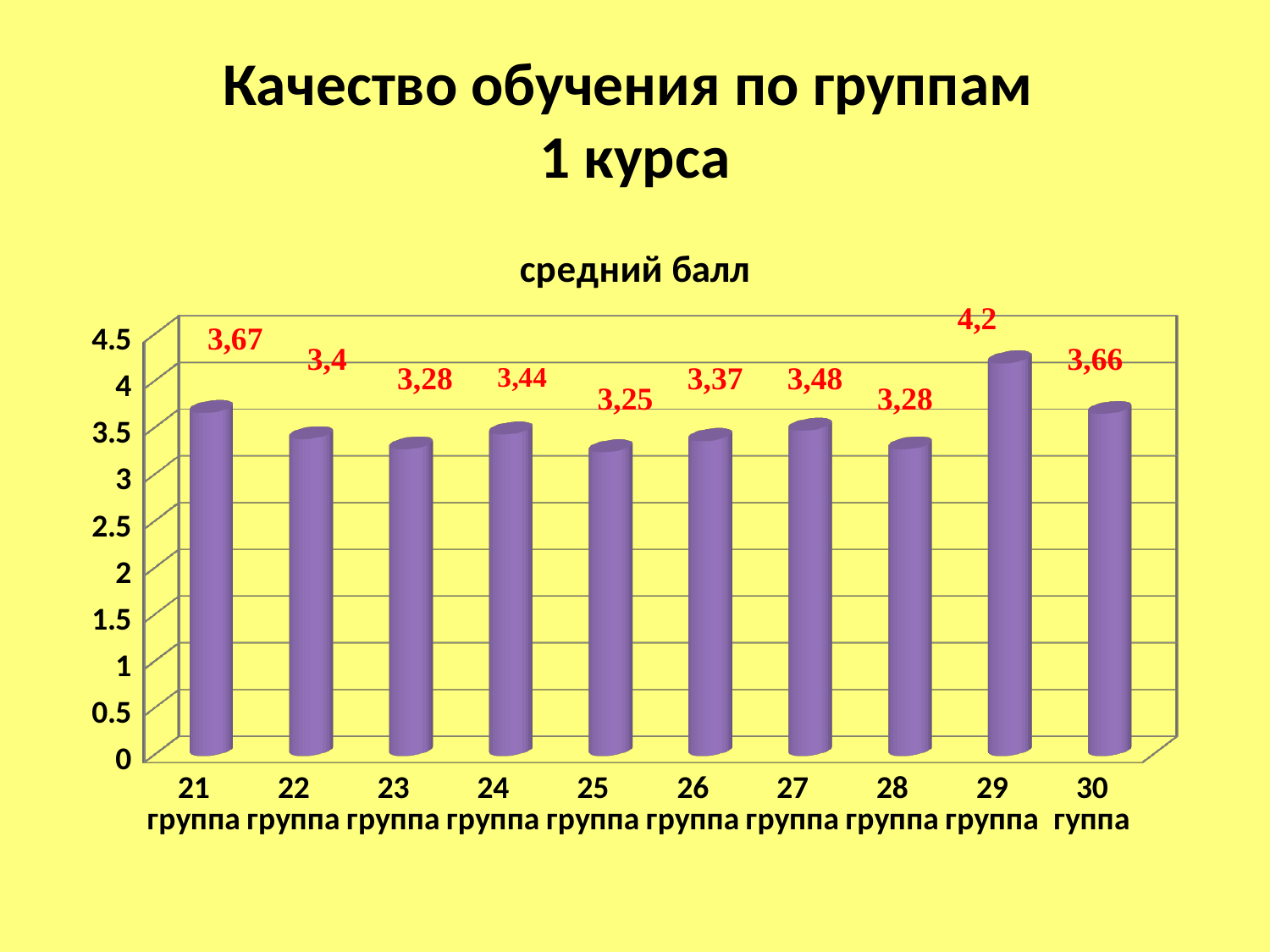
What is the value shown for 25 группа? 3,25 What is the difference between the values for 21 группа and 22 группа? 0,27 Which group has the highest average score? 29 группа What is the difference between the values for 29 группа and 25 группа? 0,95 What is the value shown for 29 группа? 4,2 What kind of chart is shown on the slide? bar chart Is the value for 29 группа greater or less than 4? greater What is the title of the chart? средний балл Which group has the lowest average score? 25 группа Which has a higher value, 27 группа or 26 группа? 27 группа How many groups are shown on the chart? 10 What is the average score (средний балл) for 21 группа? 3,67